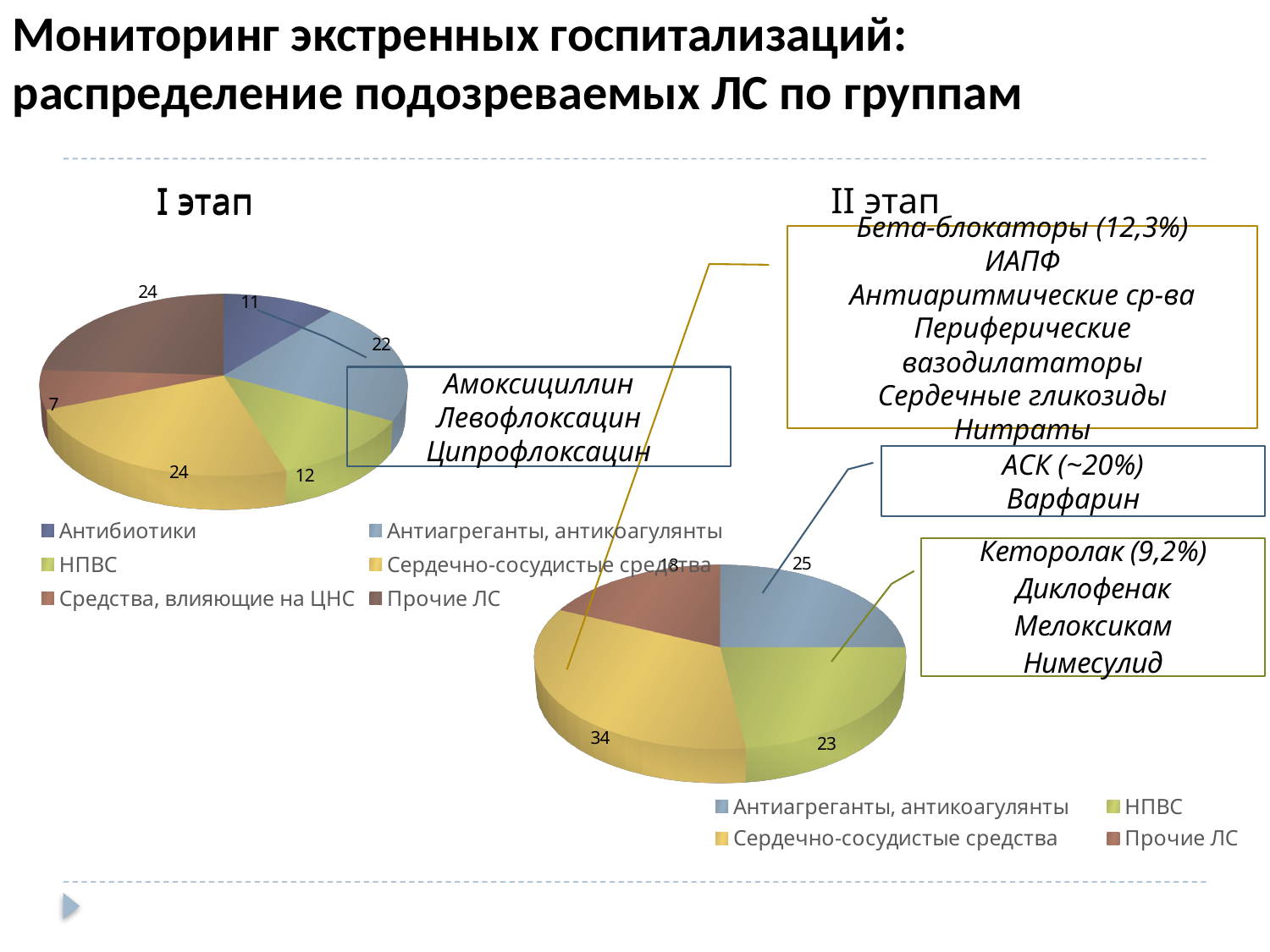
What kind of chart is the "I этап" chart? pie chart In the "II этап" chart, which category has the largest value? Сердечно-сосудистые средства In the "I этап" chart, what is the difference between Сердечно-сосудистые средства and НПВС? 12 In the "I этап" chart, which category has the smallest value? Средства, влияющие на ЦНС How many categories does the "I этап" pie chart have? 6 In the "I этап" chart, which is larger: Антиагреганты, антикоагулянты or НПВС? Антиагреганты, антикоагулянты In the "I этап" chart, what is the value for Антиагреганты, антикоагулянты? 22 In the "II этап" chart, what is the value for Сердечно-сосудистые средства? 34 How many categories does the "II этап" pie chart have? 4 In the "I этап" chart, what is the value for Антибиотики? 11 In the "II этап" chart, which is larger: Антиагреганты, антикоагулянты or НПВС? Антиагреганты, антикоагулянты In the "II этап" chart, what is the difference between Сердечно-сосудистые средства and Антиагреганты, антикоагулянты? 9